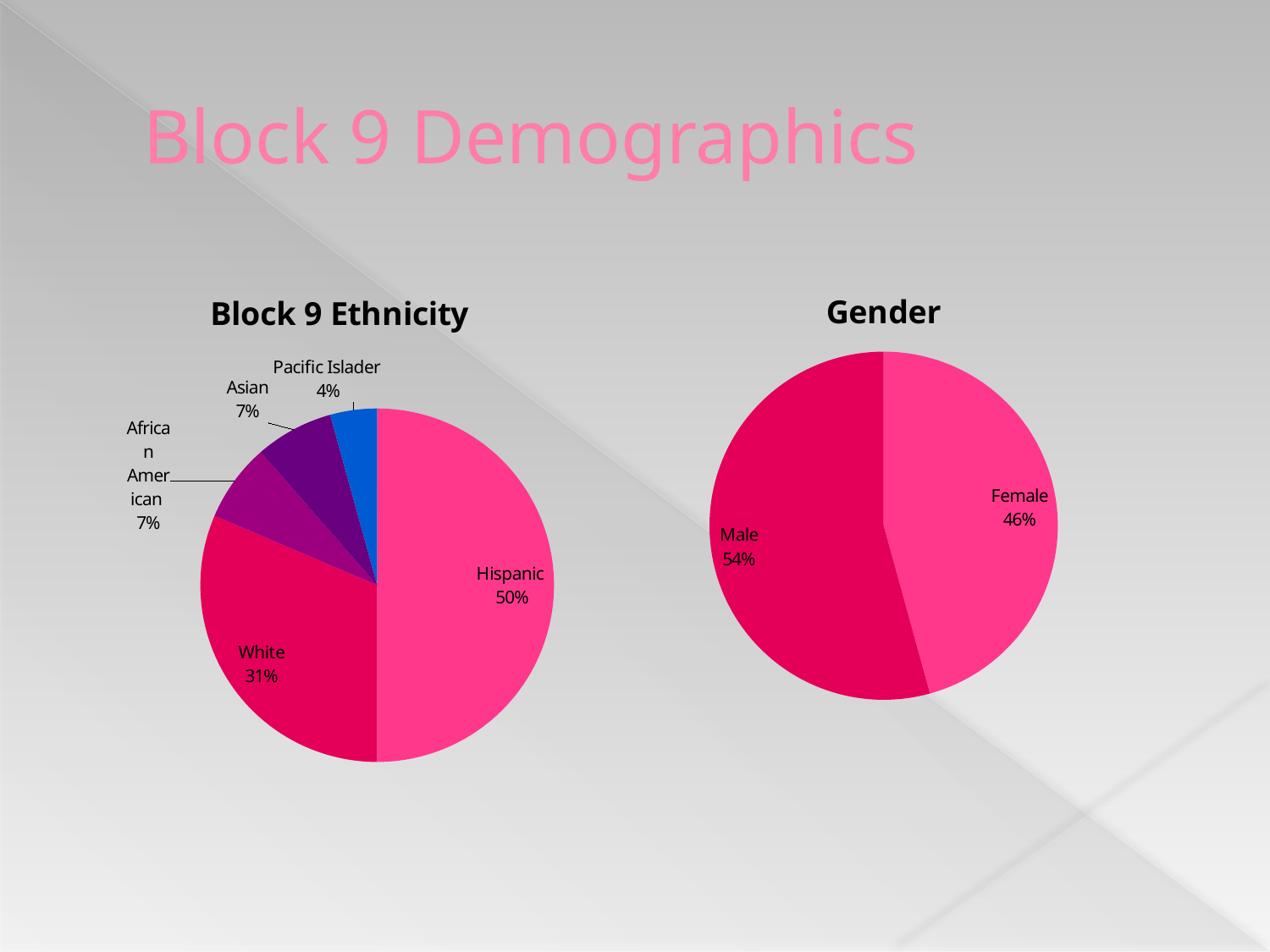
In the Block 9 Ethnicity chart, what percentage is Hispanic? 50% In the Block 9 Ethnicity chart, what percentage is White? 31% In the Block 9 Ethnicity chart, what percentage is Pacific Islader? 4% In the Block 9 Ethnicity chart, which category has the largest share? Hispanic What type of chart is the Gender chart? Pie chart In the Gender chart, which is larger, Male or Female? Male In the Block 9 Ethnicity chart, which category has the smallest share? Pacific Islader In the Gender chart, what percentage is Female? 46% In the Gender chart, what percentage is Male? 54% In the Block 9 Ethnicity chart, how many categories are shown? 5 In the Block 9 Ethnicity chart, what is the difference between the Hispanic and White shares? 19% In the Gender chart, what is the difference between the Male and Female shares? 8%